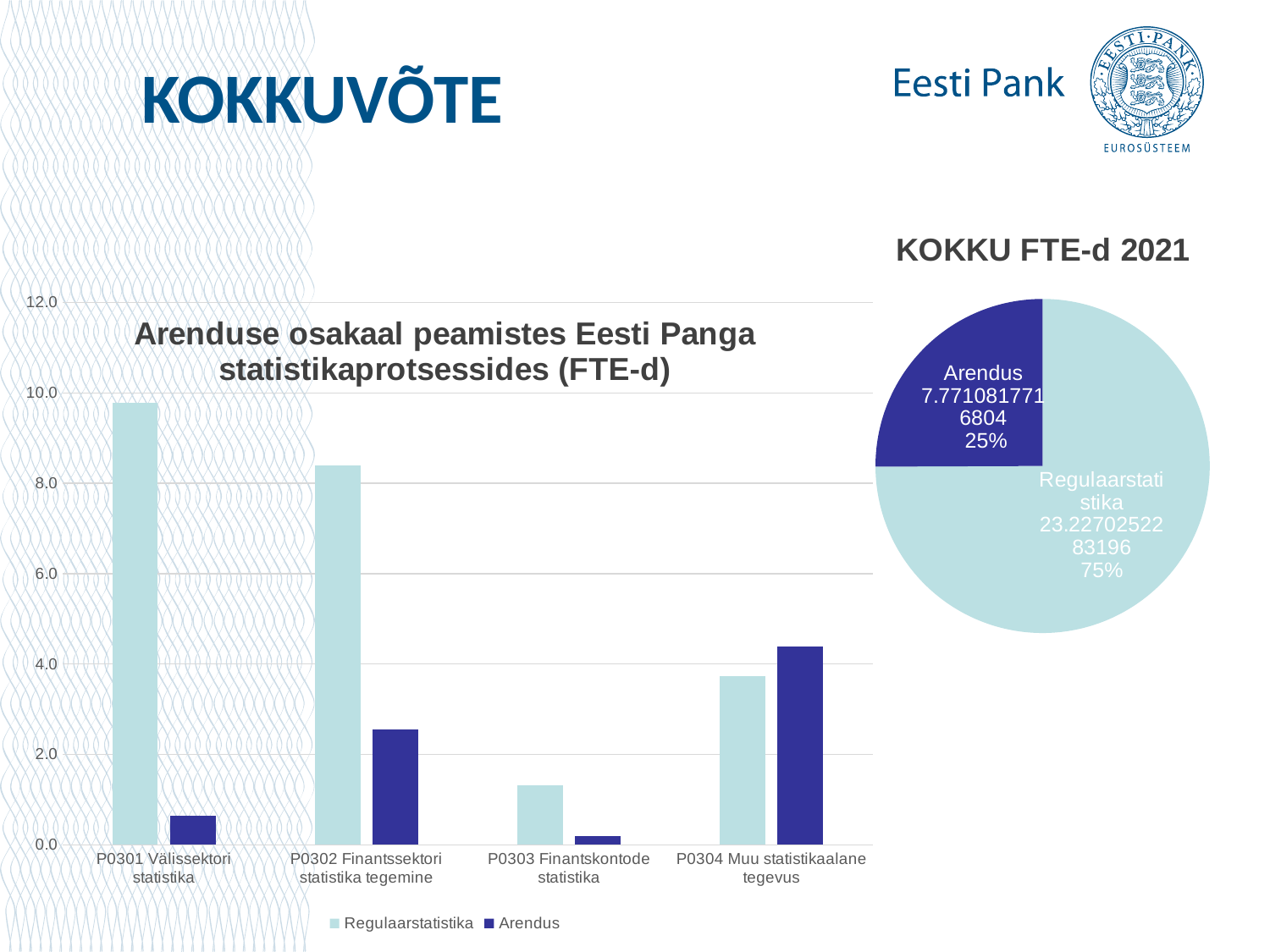
What kind of chart is the chart on the right titled "KOKKU FTE-d 2021"? pie chart In the pie chart "KOKKU FTE-d 2021", what value is shown for Regulaarstatistika? 23.2270252283196 In the pie chart "KOKKU FTE-d 2021", what share does Arendus have? 25% In the bar chart on the left, which category has the highest Regulaarstatistika value? P0301 Välissektori statistika In the bar chart on the left, is the Regulaarstatistika value for P0301 Välissektori statistika greater or less than 8.0? greater In the bar chart on the left, is the Regulaarstatistika value for P0303 Finantskontode statistika greater or less than 2.0? less In the bar chart on the left, for P0304 Muu statistikaalane tegevus, which is larger: Regulaarstatistika or Arendus? Arendus In the bar chart on the left, how many series does the legend list? 2 In the bar chart on the left, how many categories are shown on the x axis? 4 In the pie chart "KOKKU FTE-d 2021", which slice is the largest? Regulaarstatistika In the bar chart on the left, which category has the lowest Arendus value? P0303 Finantskontode statistika What kind of chart is the chart on the left titled "Arenduse osakaal peamistes Eesti Panga statistikaprotsessides (FTE-d)"? bar chart